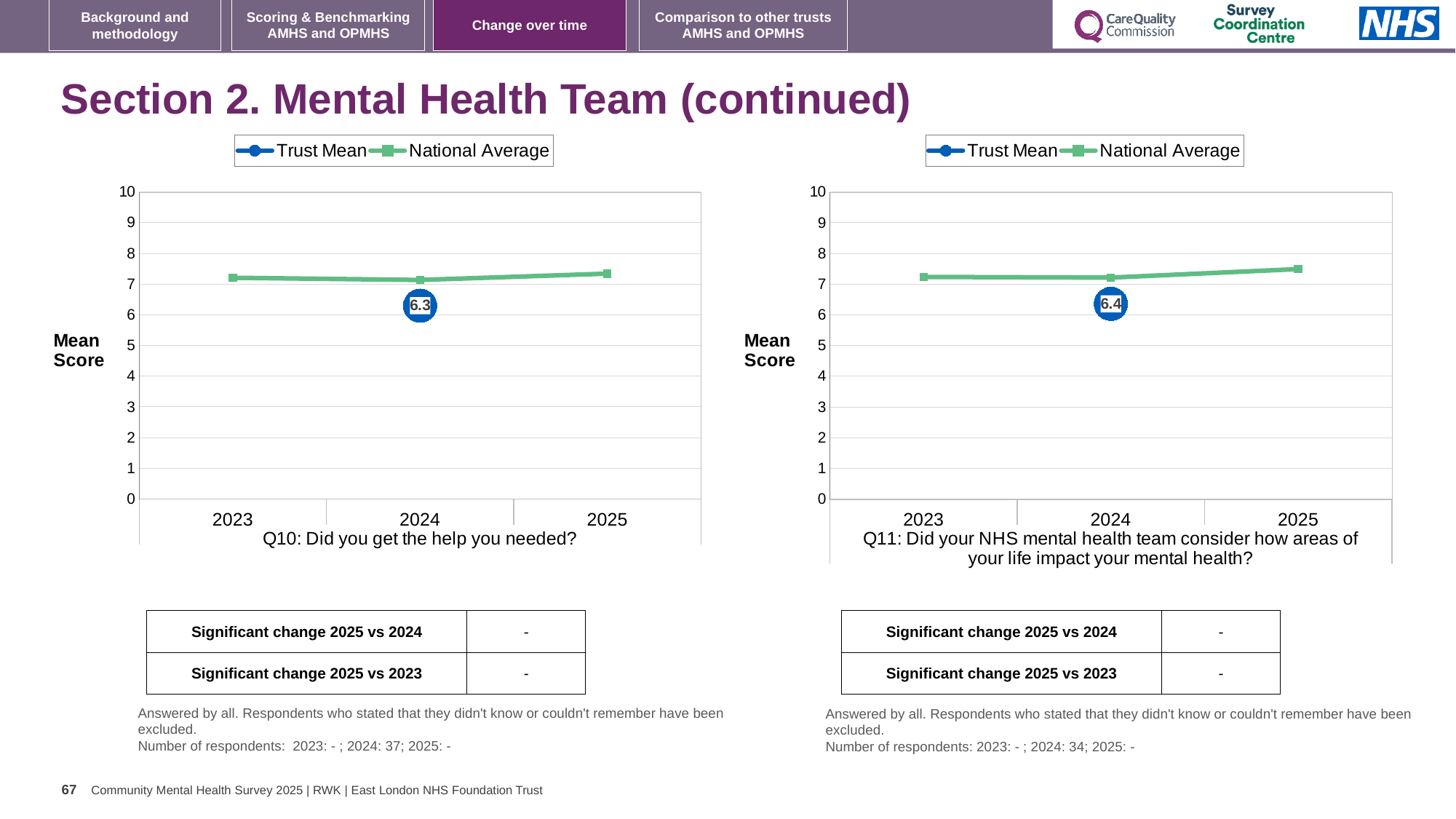
In the Q11 chart on the right, is the Trust Mean value for 2024 greater or less than 7? less In the Q10 chart on the left, is the National Average value for 2025 greater or less than 7? greater How many years are shown on the x axis of the Q10 chart on the left? 3 In the Q11 chart on the right, which is higher in 2024: the Trust Mean or the National Average? National Average How many series does the legend of the Q10 chart on the left list? 2 What kind of chart is the Q11 chart on the right? Line chart In the Q10 chart on the left, what is the Trust Mean value for 2024? 6.3 In the Q11 chart on the right, is the National Average value for 2023 greater or less than 7? greater What are the two legend entries in the Q10 chart on the left? Trust Mean and National Average In the Q11 chart on the right, what is the Trust Mean value for 2024? 6.4 In the Q10 chart on the left, which is higher in 2024: the Trust Mean or the National Average? National Average What is the y-axis label of the Q11 chart on the right? Mean Score